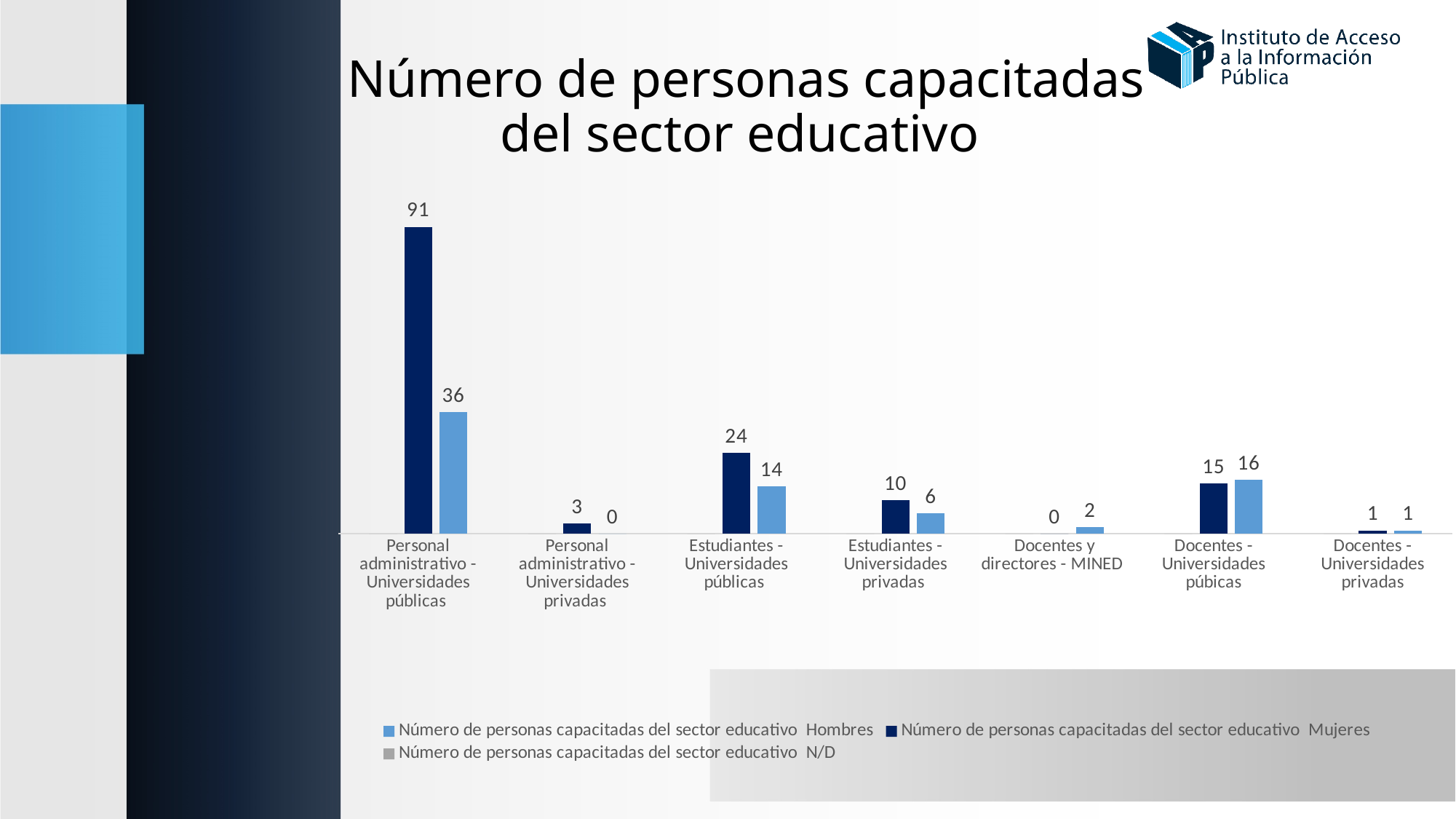
For Docentes - Universidades púbicas, which is larger: the Hombres value or the Mujeres value? Hombres How many series does the legend list? 3 What is the value of the Mujeres (dark blue) bar for Docentes - Universidades privadas? 1 What is the difference between the Mujeres and Hombres values for Personal administrativo - Universidades públicas? 55 What is the combined total of the Mujeres and Hombres values for Estudiantes - Universidades privadas? 16 What is the value of the Hombres (light blue) bar for Estudiantes - Universidades públicas? 14 What kind of chart is shown on the slide? Bar chart Which category has the highest Mujeres (dark blue) value? Personal administrativo - Universidades públicas What is the value of the Mujeres (dark blue) bar for Personal administrativo - Universidades públicas? 91 What is the title of the slide? Número de personas capacitadas del sector educativo What is the value of the Hombres (light blue) bar for Docentes y directores - MINED? 2 How many categories are shown on the x axis? 7